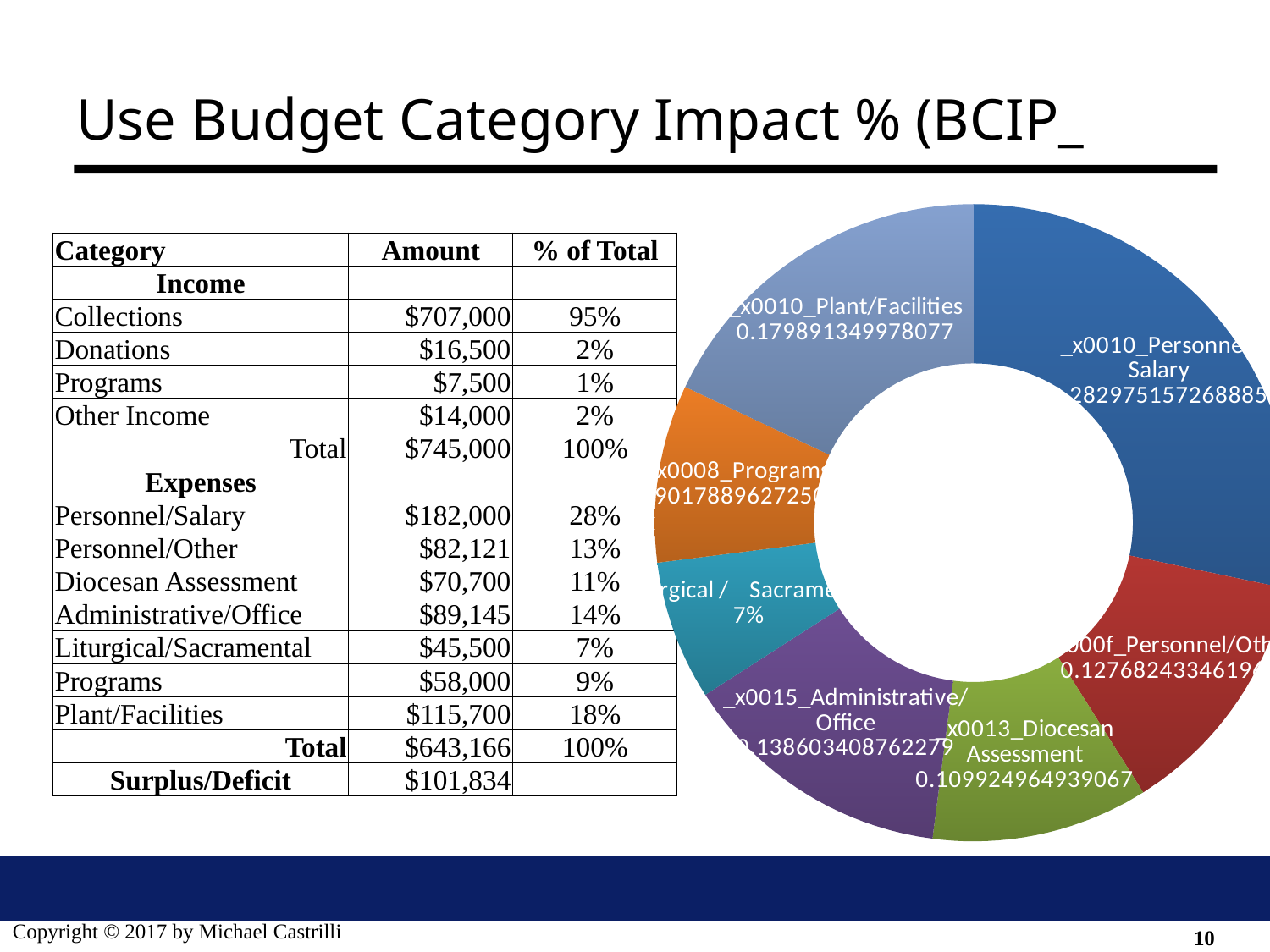
What colour is the Diocesan Assessment slice in the doughnut chart? green How many slices does the doughnut chart have? 7 In the doughnut chart, which slice is larger: Personnel/Salary or Personnel/Other? Personnel/Salary What value is labelled on the Diocesan Assessment slice of the doughnut chart? 0.109924964939067 What colour is the Personnel/Salary slice in the doughnut chart? blue In the doughnut chart, which slice is larger: Plant/Facilities or Diocesan Assessment? Plant/Facilities Which category has the largest slice in the doughnut chart? Personnel/Salary What kind of chart is shown on the slide? doughnut chart In the doughnut chart, which slice is larger: Personnel/Salary or Plant/Facilities? Personnel/Salary What percentage is labelled on the Liturgical / Sacramental slice of the doughnut chart? 7% What value is labelled on the Plant/Facilities slice of the doughnut chart? 0.179891349978077